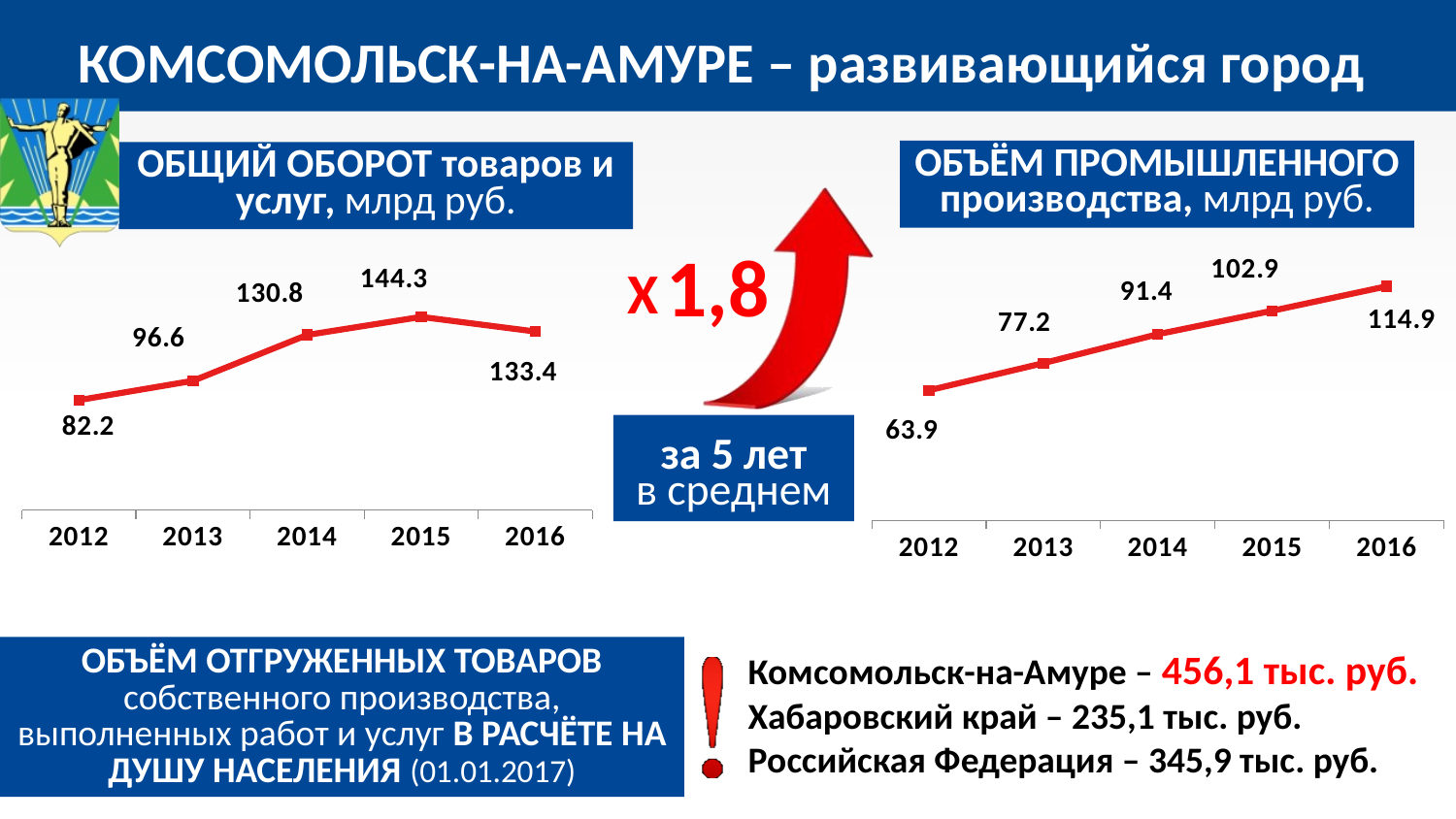
In the left chart (ОБЩИЙ ОБОРОТ товаров и услуг), is the value for 2013 larger or smaller than the value for 2016? smaller How many years are plotted in the right chart (ОБЪЁМ ПРОМЫШЛЕННОГО производства)? 5 In the right chart (ОБЪЁМ ПРОМЫШЛЕННОГО производства), what is the value for 2016? 114.9 In the left chart (ОБЩИЙ ОБОРОТ товаров и услуг), which year has the highest value? 2015 In the right chart (ОБЪЁМ ПРОМЫШЛЕННОГО производства), do the values rise or fall from 2012 to 2016? rise What unit is stated in the title of the right chart (ОБЪЁМ ПРОМЫШЛЕННОГО производства)? млрд руб. In the left chart (ОБЩИЙ ОБОРОТ товаров и услуг), what is the difference between the 2015 and 2016 values? 10.9 In the left chart (ОБЩИЙ ОБОРОТ товаров и услуг), which year has the lowest value? 2012 In the right chart (ОБЪЁМ ПРОМЫШЛЕННОГО производства), what is the difference between the 2016 and 2012 values? 51.0 What type of chart is the left chart (ОБЩИЙ ОБОРОТ товаров и услуг)? line chart In the chart titled "ОБЩИЙ ОБОРОТ товаров и услуг, млрд руб." (left), what is the value for 2014? 130.8 In the chart titled "ОБЪЁМ ПРОМЫШЛЕННОГО производства, млрд руб." (right), what is the value for 2012? 63.9